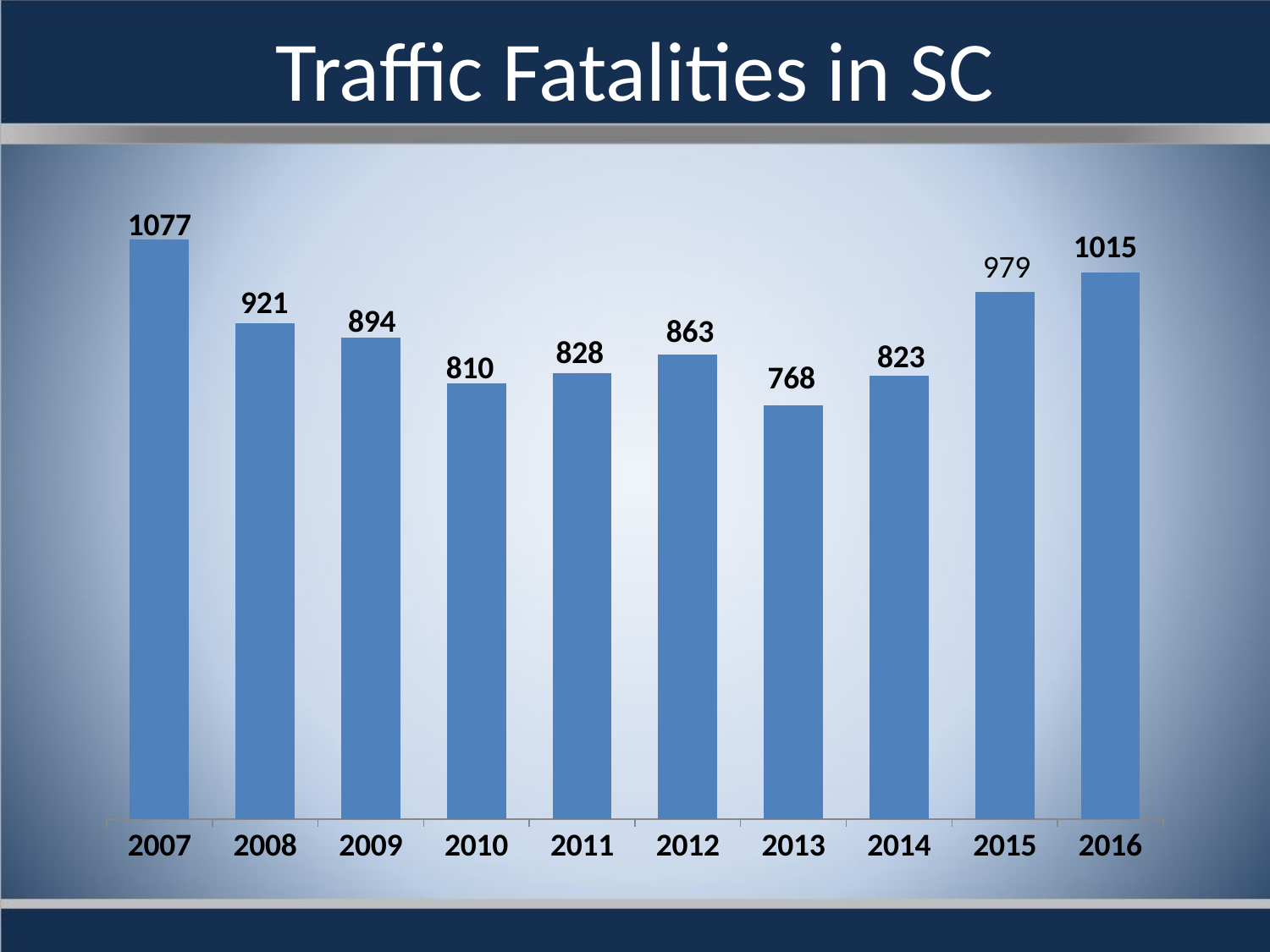
What was the number of traffic fatalities in SC in 2013? 768 Did traffic fatalities rise or fall from 2013 to 2016? Rise Which year had more traffic fatalities, 2008 or 2009? 2008 What is the difference in traffic fatalities between 2007 and 2013? 309 What kind of chart is shown on the slide? Bar chart What was the number of traffic fatalities in SC in 2015? 979 What is the difference in traffic fatalities between 2016 and 2015? 36 How many years are shown on the chart? 10 What was the number of traffic fatalities in SC in 2007? 1077 Which year had more traffic fatalities, 2012 or 2014? 2012 Which year had the lowest number of traffic fatalities? 2013 Which year had the highest number of traffic fatalities? 2007